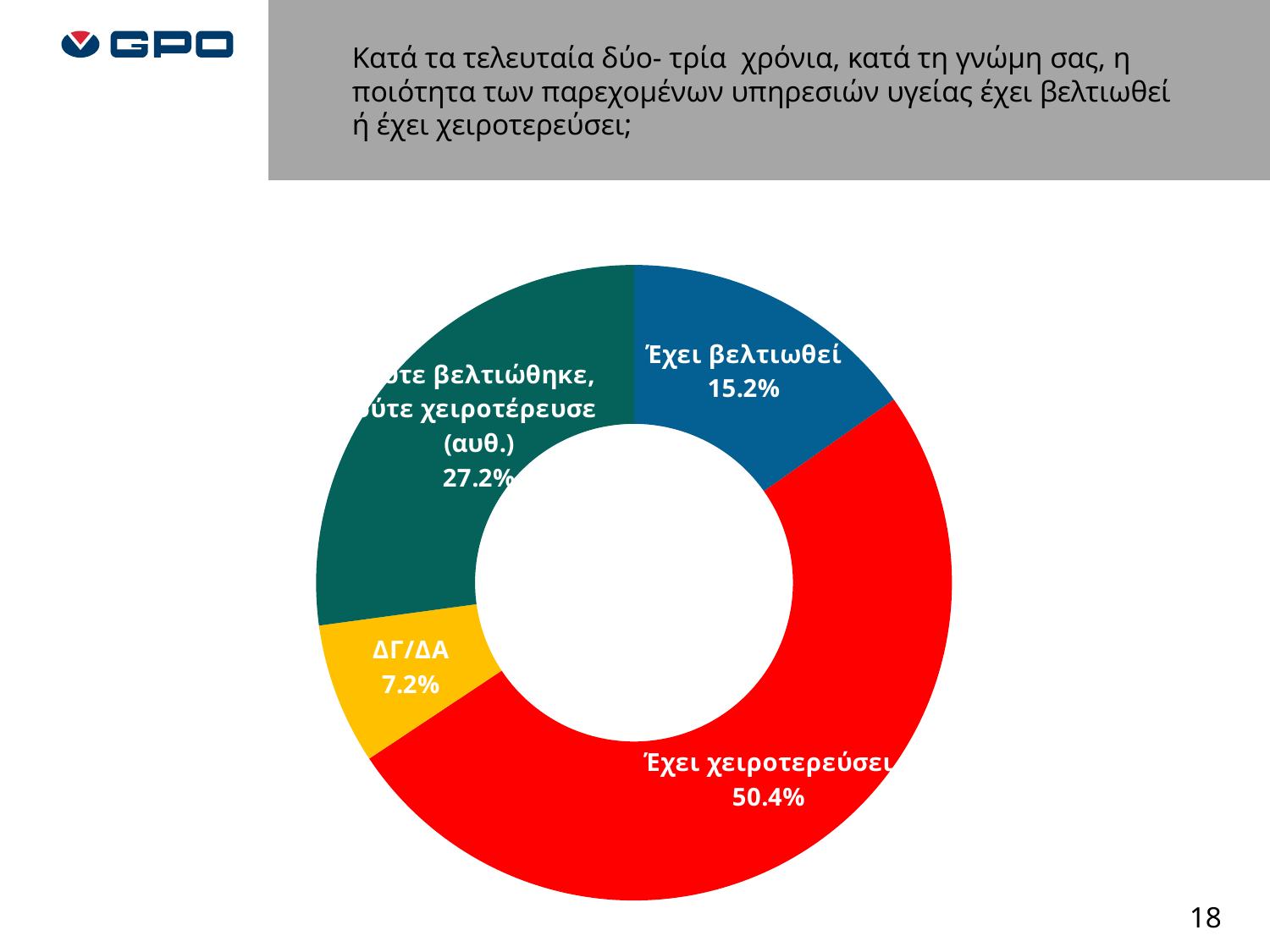
What colour is the "Έχει χειροτερεύσει" slice? Red Which response has the smallest share of the chart? ΔΓ/ΔΑ What is the value of the "ΔΓ/ΔΑ" slice? 7.2% Which is larger: the share for "Έχει βελτιωθεί" or the share for "Ούτε βελτιώθηκε, ούτε χειροτέρευσε (αυθ.)"? Ούτε βελτιώθηκε, ούτε χειροτέρευσε (αυθ.) What share of respondents answered "Έχει χειροτερεύσει"? 50.4% How many slices does the chart have? 4 What is the difference in percentage points between "Έχει χειροτερεύσει" and "Έχει βελτιωθεί"? 35.2 Which response has the largest share of the chart? Έχει χειροτερεύσει What percentage is shown for "Ούτε βελτιώθηκε, ούτε χειροτέρευσε (αυθ.)"? 27.2% What percentage is shown for "Έχει βελτιωθεί"? 15.2% What is the difference in percentage points between "Ούτε βελτιώθηκε, ούτε χειροτέρευσε (αυθ.)" and "ΔΓ/ΔΑ"? 20.0 What kind of chart is shown on the slide? Doughnut (pie) chart